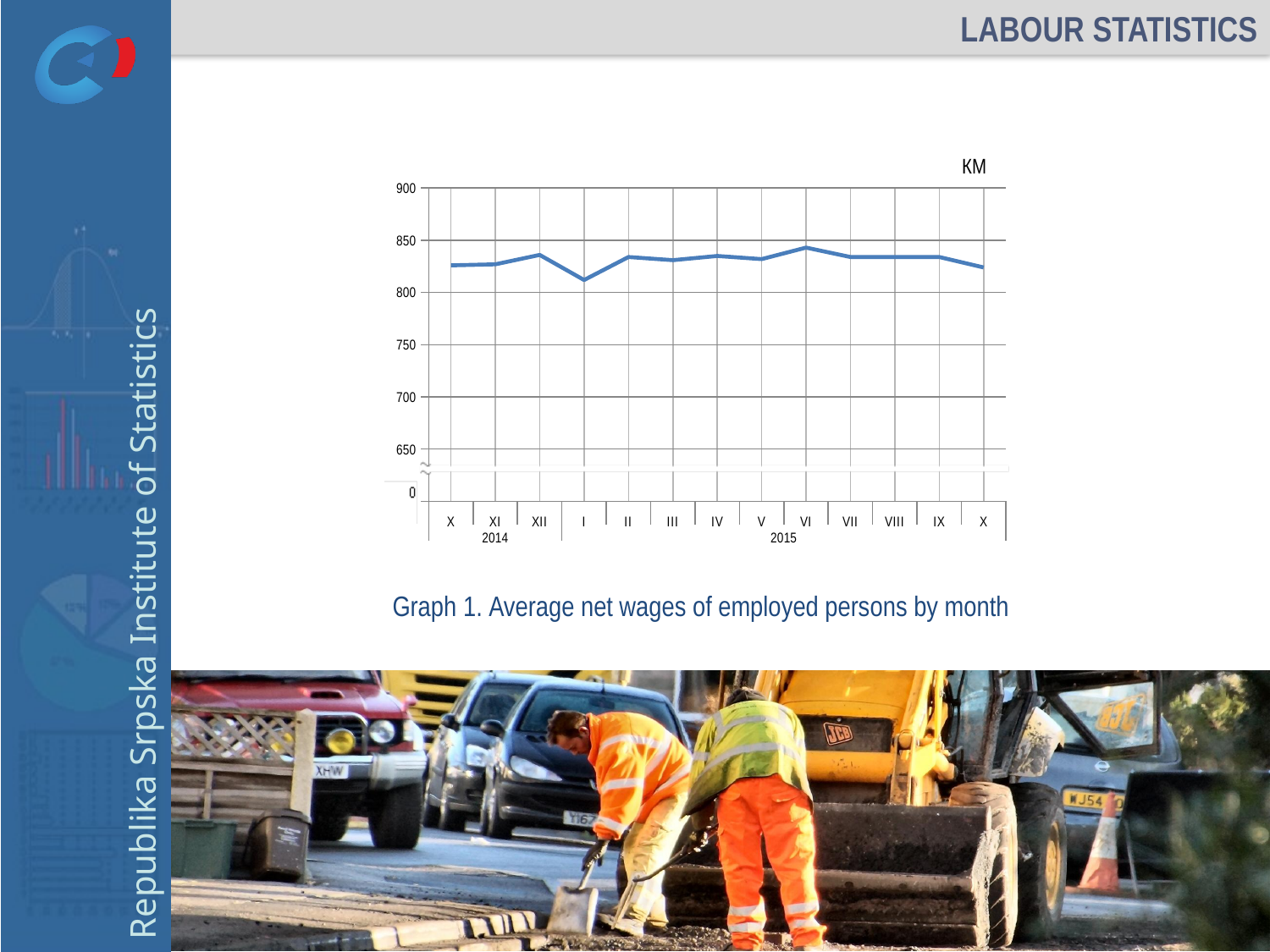
Is the value for X 2014 greater or less than 800? greater Is the value for I 2015 greater or less than 850? less Is the value for I 2015 greater or less than 800? greater Which is larger, the value for I 2015 or the value for VI 2015? VI 2015 How many monthly data points are plotted on the line? 13 Does the line rise or fall from I 2015 to II 2015? rise Which month has the lowest average net wage on the chart? I 2015 Does the line rise or fall from XII 2014 to I 2015? fall What kind of chart is shown on the slide? line chart What unit is shown at the top of the vertical axis? KM What is the title of the graph on the slide? Graph 1. Average net wages of employed persons by month